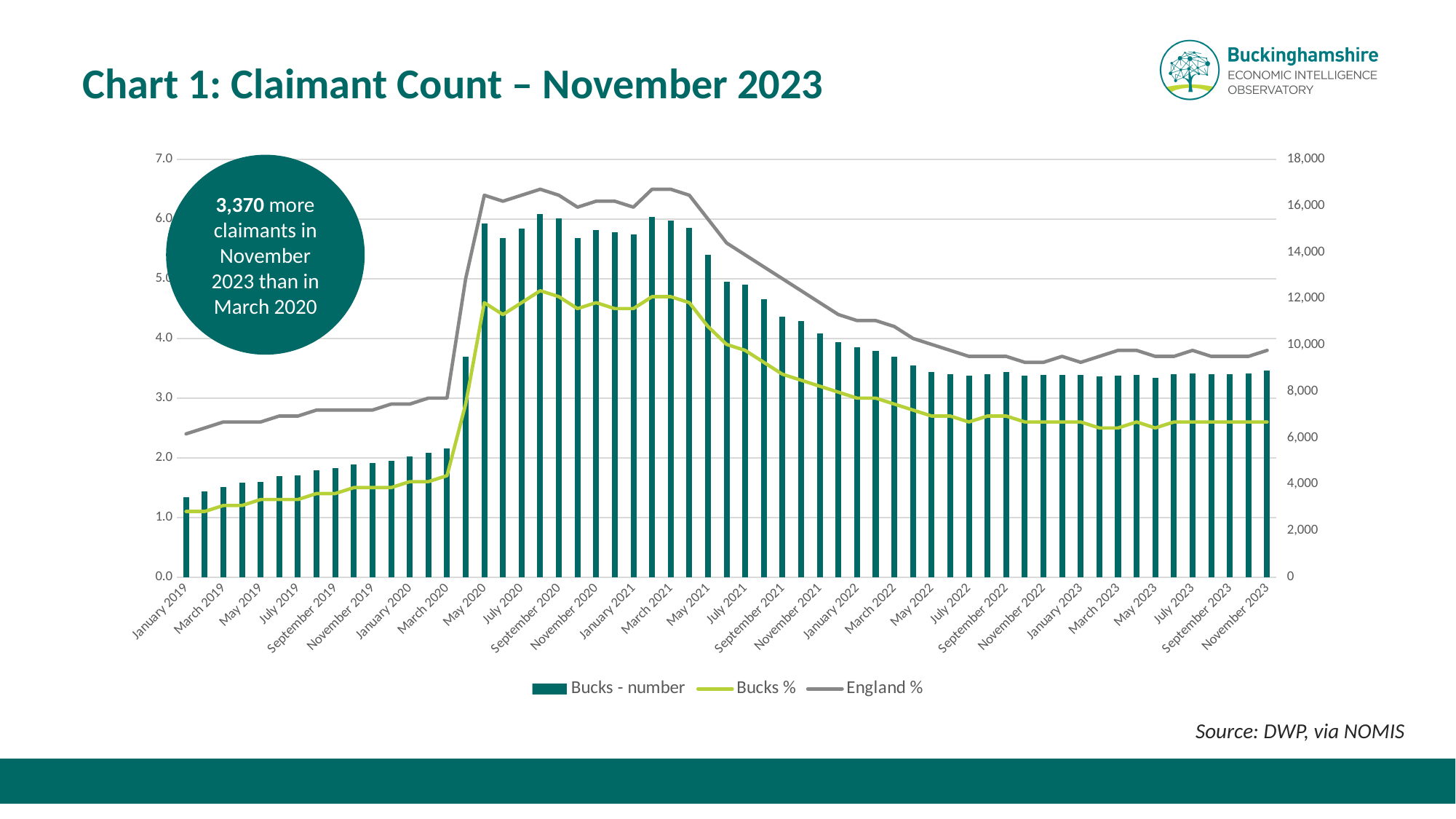
Is the Bucks - number value for November 2023 greater or less than 8,000? greater What kind of chart is shown on the slide? A combined bar and line chart Which month has the lowest Bucks - number bar? January 2019 How many series does the legend list? 3 Which series is plotted as bars? Bucks - number Is the Bucks - number value for January 2019 greater or less than 4,000? less Is the England % value for September 2020 greater or less than 6.0? greater What is the source given for the chart? DWP, via NOMIS Does the Bucks - number series rise or fall between May 2020 and May 2022? Fall In November 2023, which is higher: Bucks % or England %? England %